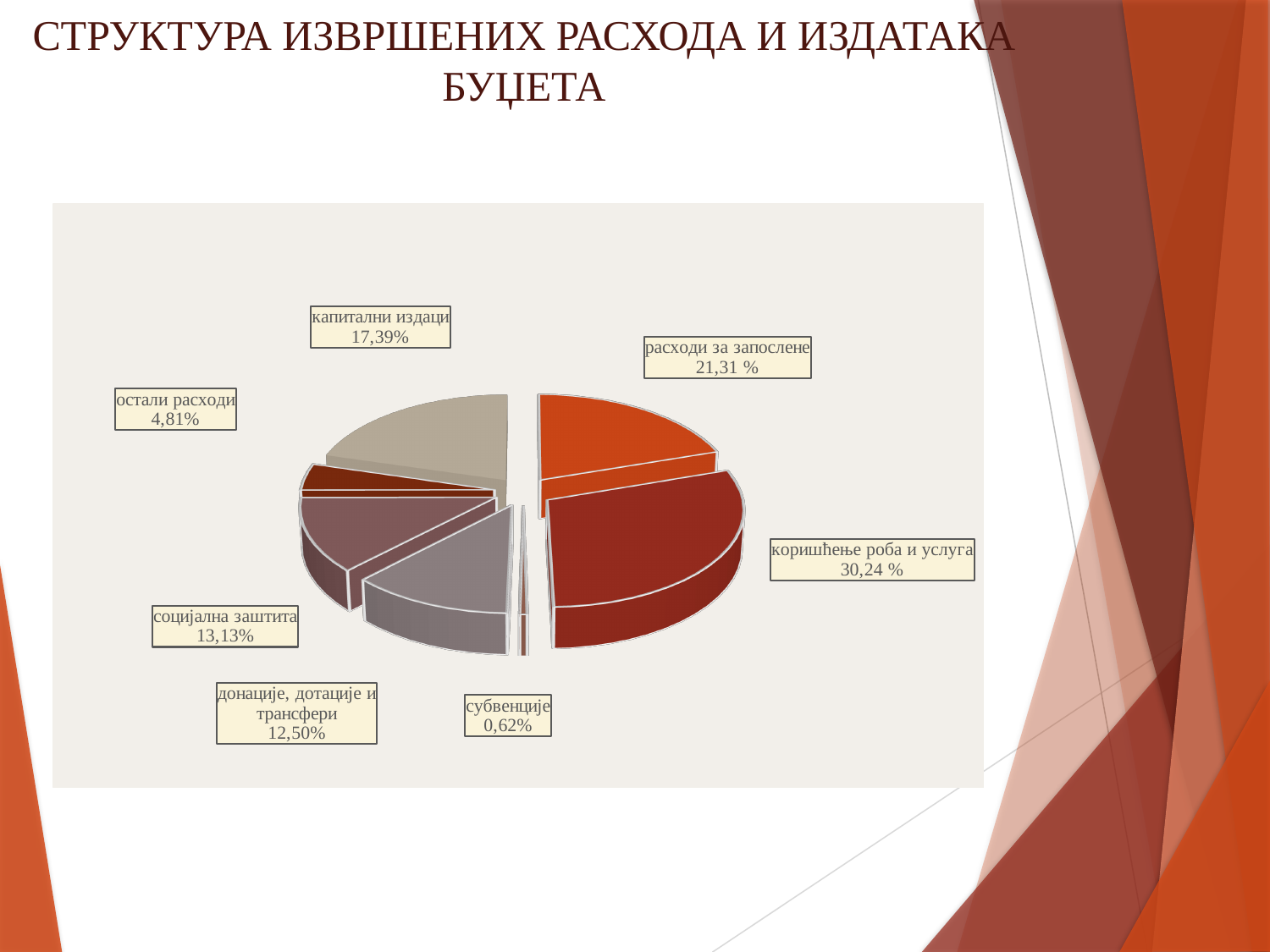
Which is larger: остали расходи or донације, дотације и трансфери? донације, дотације и трансфери What is the value shown for расходи за запослене? 21,31 % What percentage is labelled for субвенције? 0,62% What is the difference in percentage points between коришћење роба и услуга and расходи за запослене? 8,93 Which category has the smallest share of the pie? субвенције What percentage is shown for капитални издаци? 17,39% What is the value for социјална заштита? 13,13% What is the difference in percentage points between капитални издаци and социјална заштита? 4,26 What type of chart is shown on the slide? pie chart How many slices does the pie chart have? 7 What share of the pie does коришћење роба и услуга represent? 30,24 % Which category has the largest share of the pie? коришћење роба и услуга